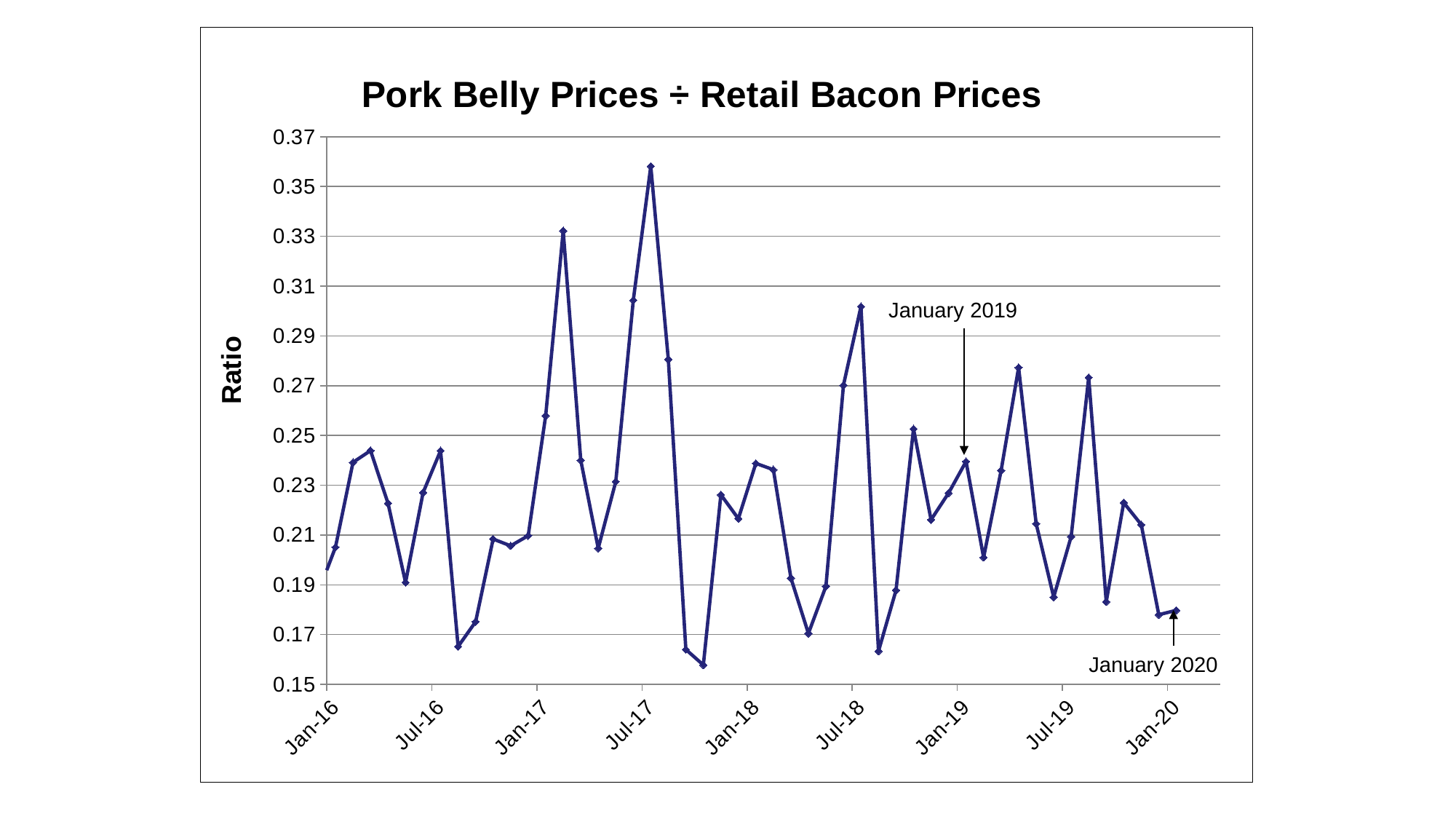
Does the ratio rise or fall overall from January 2019 to January 2020? fall Is the value for Jan-18 greater or less than 0.25? less Is the value for Jul-17 greater or less than 0.29? greater Is the value for Jul-18 greater or less than 0.25? greater What is the label on the vertical axis of the chart? Ratio What is the title of the chart? Pork Belly Prices ÷ Retail Bacon Prices Which is larger, the value for January 2019 or the value for January 2020? January 2019 What kind of chart is shown on the slide? line chart